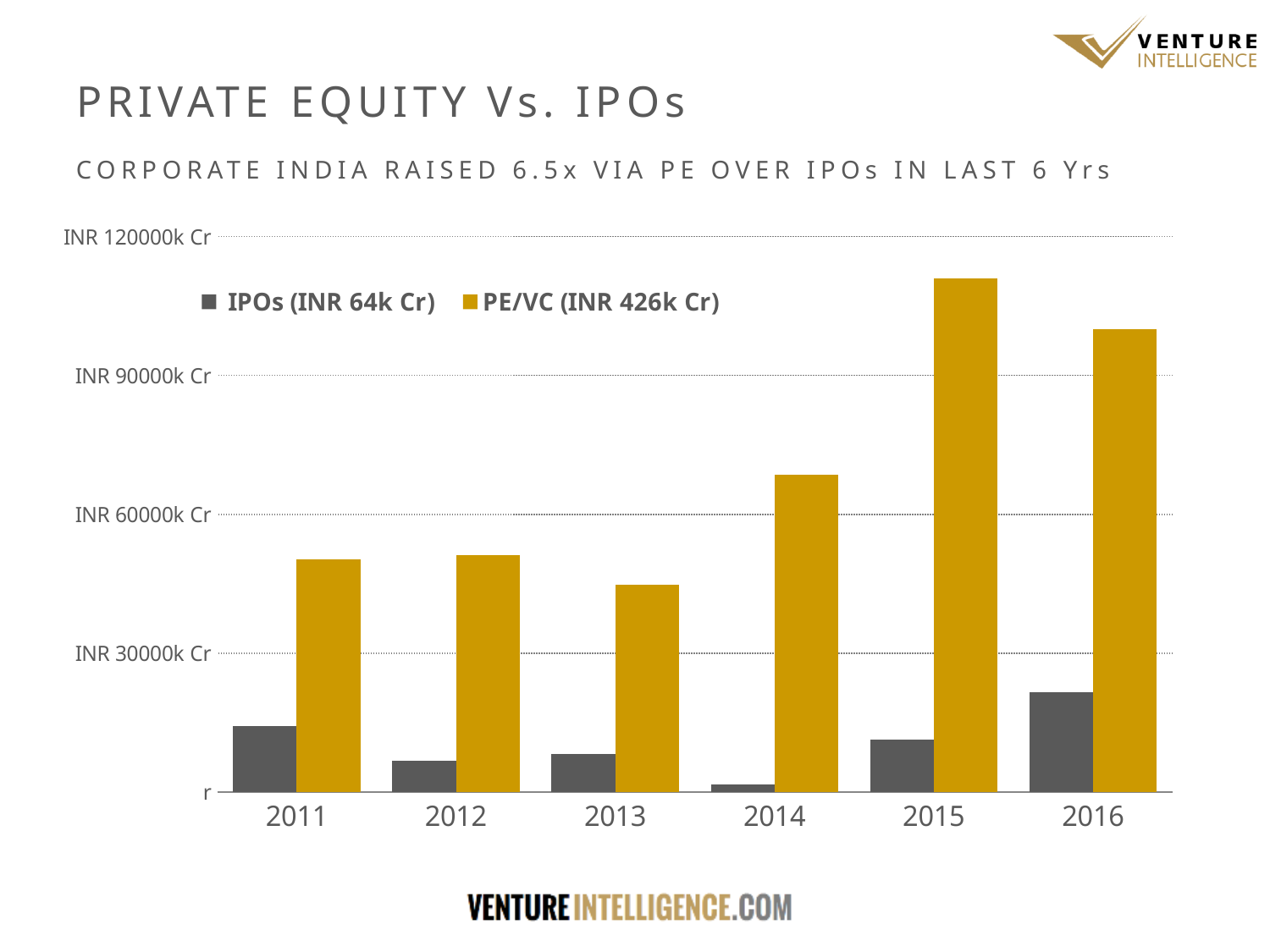
What total amount does the legend give for the PE/VC series? INR 426k Cr Is the PE/VC value for 2013 greater or less than INR 60000k Cr? less How many series does the chart's legend list? 2 Is the PE/VC value for 2015 greater or less than INR 90000k Cr? greater In which year is the PE/VC bar the highest? 2015 Do the PE/VC values rise or fall from 2013 to 2015? Rise In which year is the IPOs bar the highest? 2016 Which is larger, the PE/VC value for 2014 or the PE/VC value for 2013? 2014 In which year is the IPOs bar the lowest? 2014 Is the IPOs value for 2016 greater or less than INR 30000k Cr? less How many years are shown on the x axis of the chart? 6 What kind of chart is shown on the slide? Bar chart